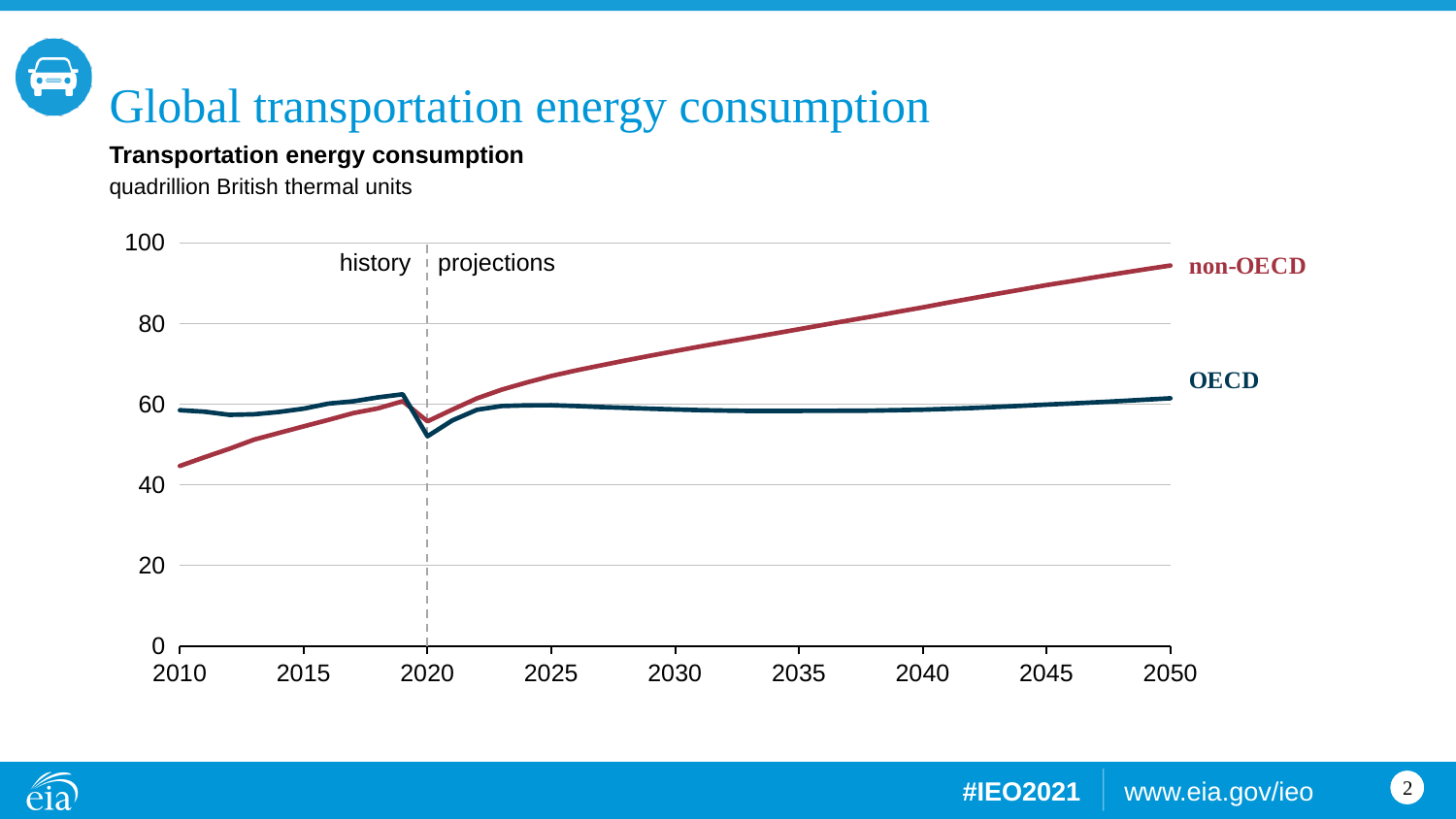
Which series has the higher value in 2050, non-OECD or OECD? non-OECD Which series has the higher value in 2010, non-OECD or OECD? OECD At which year does the dashed line separate history from projections? 2020 In what unit is transportation energy consumption measured on the chart? quadrillion British thermal units Between 2020 and 2050, does the non-OECD line rise or fall? rise What kind of chart is shown on the slide? line chart Is the value for OECD in 2020 greater or less than 60? less Is the value for non-OECD in 2030 greater or less than 60? greater Is the value for non-OECD in 2010 greater or less than 60? less How many series are plotted on the chart? 2